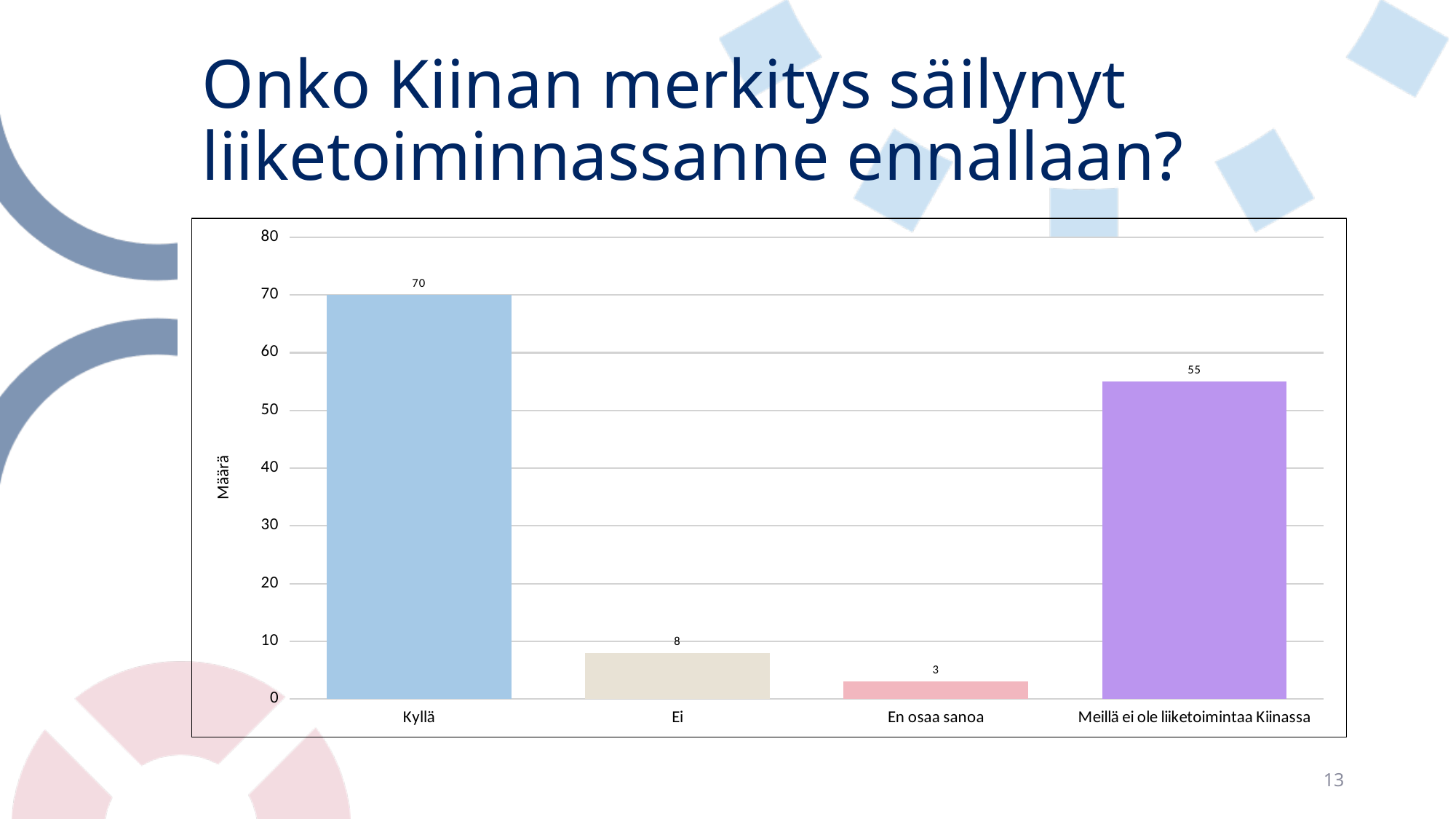
Which is larger, the value for Ei or the value for En osaa sanoa? Ei What is the value for Meillä ei ole liiketoimintaa Kiinassa? 55 What is the value for Kyllä? 70 What is the label of the vertical axis? Määrä Which category has the highest value? Kyllä Is the value for Meillä ei ole liiketoimintaa Kiinassa greater or less than 50? greater What is the value for En osaa sanoa? 3 How many categories are shown on the x axis? 4 What is the difference between the values for Kyllä and Meillä ei ole liiketoimintaa Kiinassa? 15 What kind of chart is shown on the slide? bar chart Which category has the lowest value? En osaa sanoa What is the value for Ei? 8